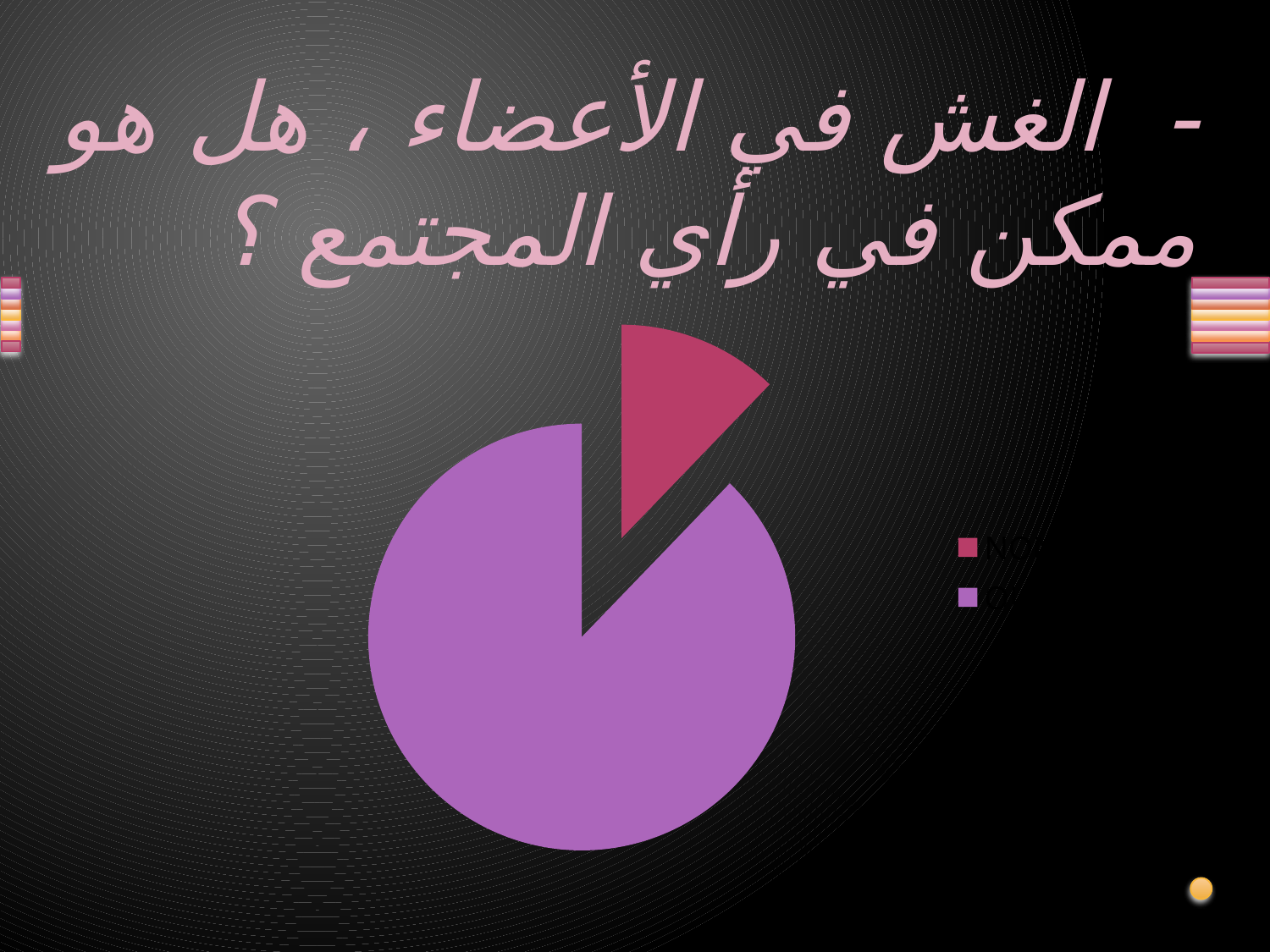
How many slices does the pie chart have? 2 What kind of chart is shown on the slide? pie chart Which slice of the pie chart is larger, the purple one or the red one? the purple one Which colour is the smallest slice of the pie chart? red How many entries does the legend of the pie chart list? 2 Which colour is the largest slice of the pie chart? purple Which slice of the pie chart is pulled out (exploded) from the rest? the red slice